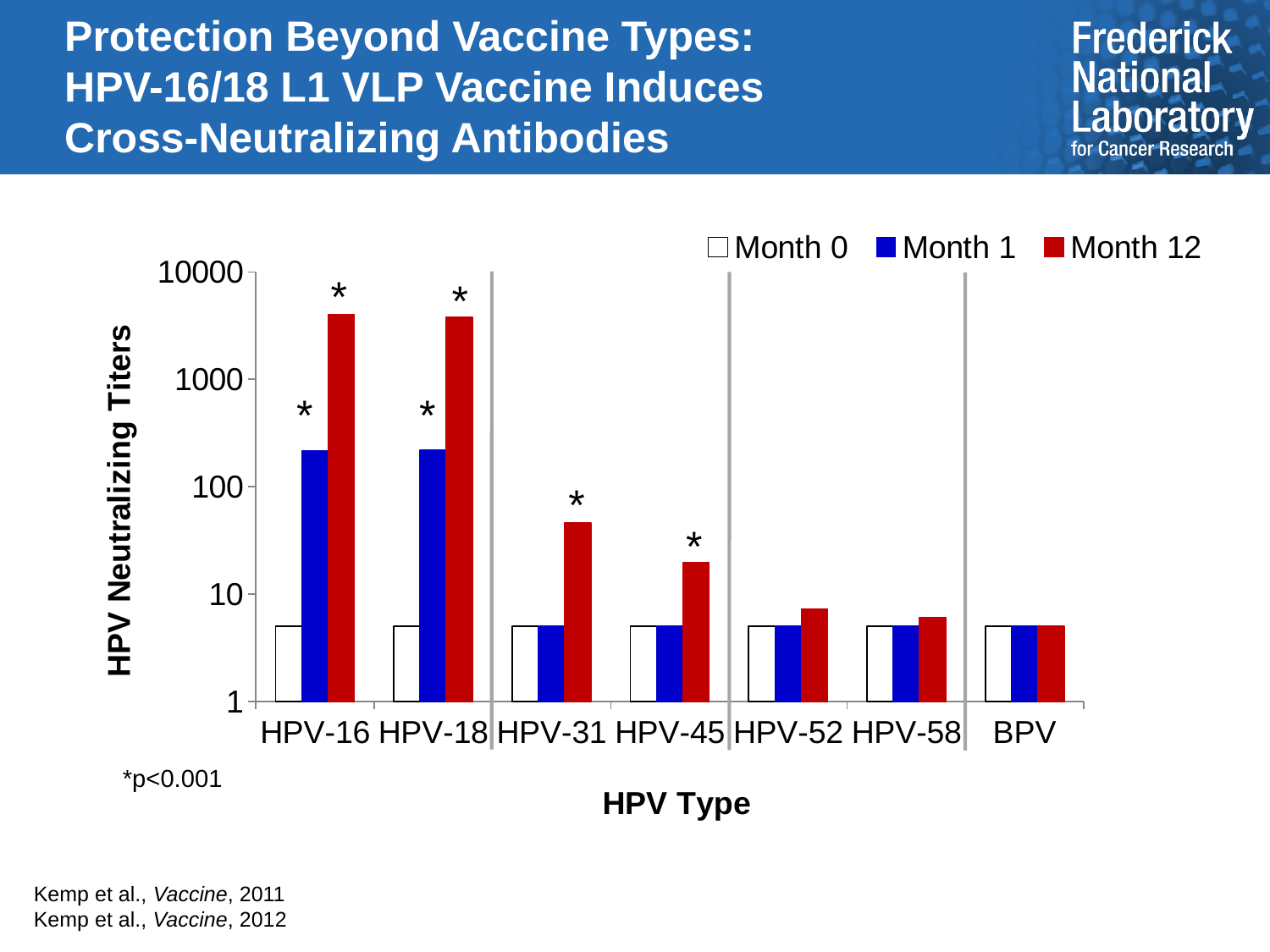
What kind of chart is shown on the slide? bar chart Which is larger, the Month 12 value for HPV-31 or the Month 12 value for HPV-45? HPV-31 Is the Month 1 value for HPV-16 greater or less than 100? greater How many HPV types (categories) are shown on the x axis? 7 What is the title of the y axis? HPV Neutralizing Titers Is the Month 12 value for HPV-45 greater or less than 10? greater Is the Month 12 value for HPV-16 greater or less than 1000? greater How many series does the legend list? 3 Which series is shown in red? Month 12 For HPV-31, which series has the highest value? Month 12